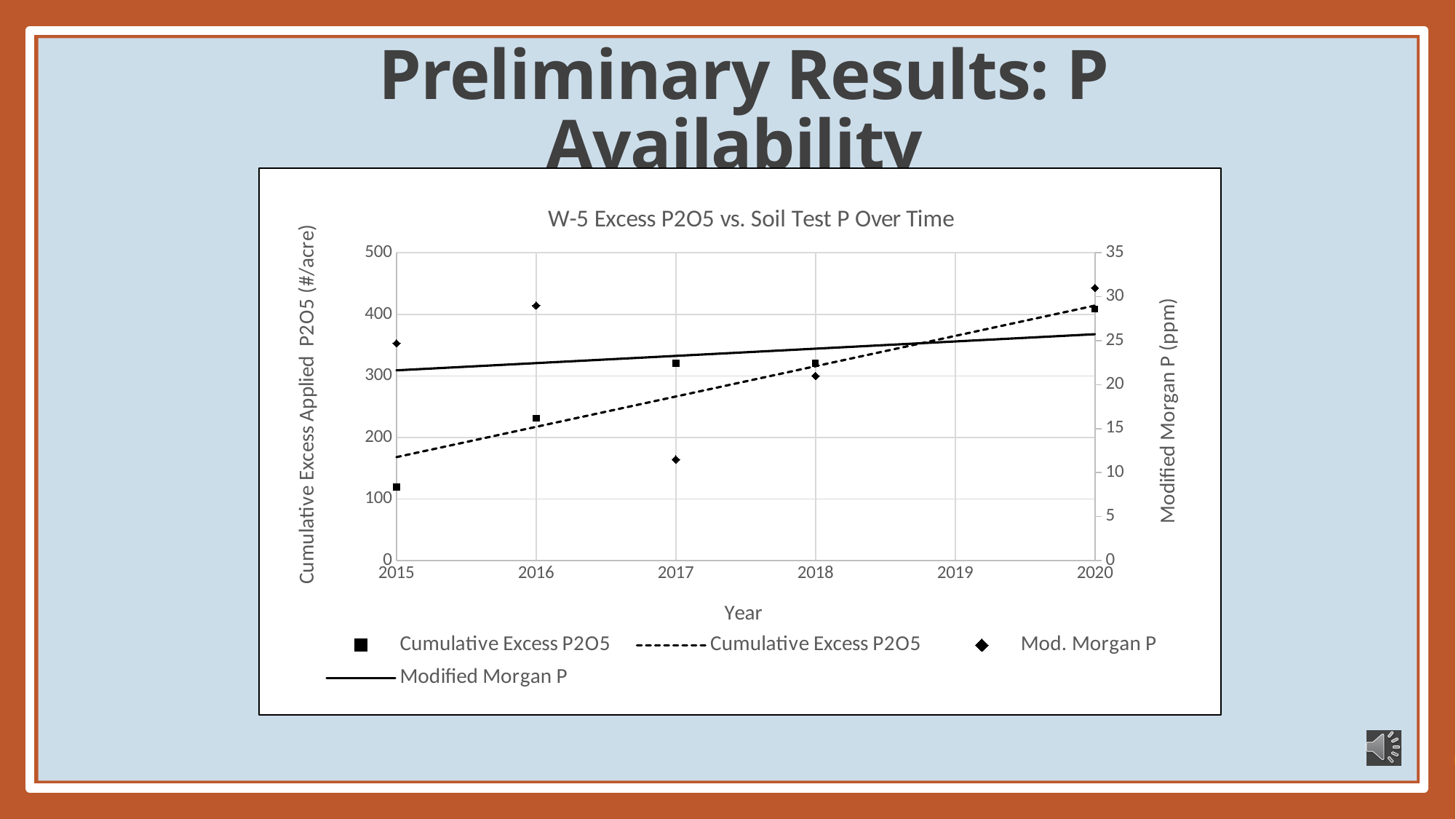
How many Cumulative Excess P2O5 data points are plotted? 5 Which year has the larger Mod. Morgan P value, 2016 or 2018? 2016 In which year is the Cumulative Excess P2O5 value highest? 2020 What is the title of the chart? W-5 Excess P2O5 vs. Soil Test P Over Time How many entries does the chart legend list? 4 In which year is the Mod. Morgan P value lowest? 2017 Is the Mod. Morgan P value for 2020 greater or less than 30? greater Is the Cumulative Excess P2O5 value for 2015 greater or less than 200? less Is the Mod. Morgan P value for 2017 greater or less than 15? less Does the Cumulative Excess P2O5 trendline rise or fall from 2015 to 2020? rise What kind of chart is this? Scatter chart with trendlines